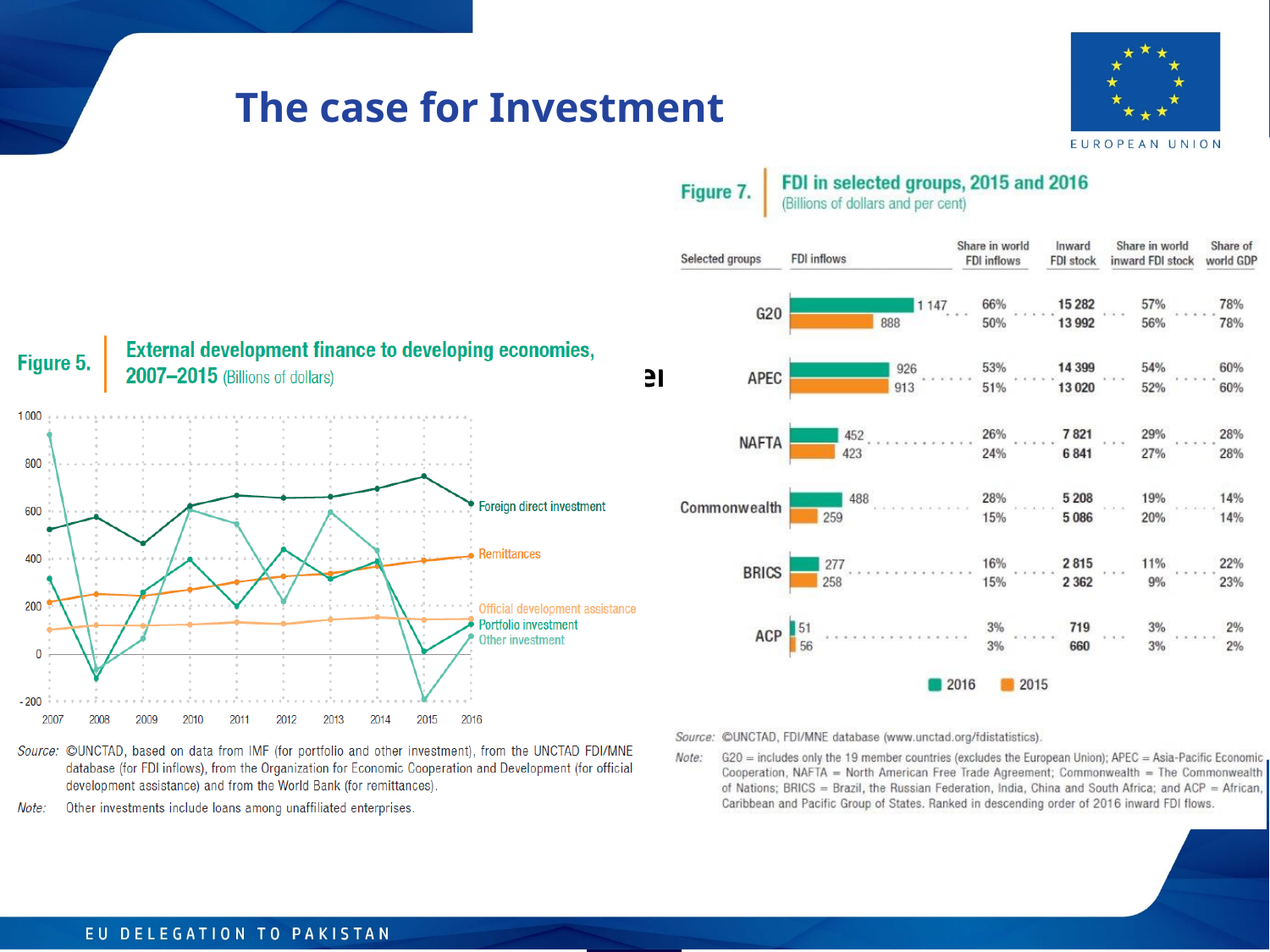
In Figure 7, how many selected groups are shown? 6 In Figure 7, what was the FDI inflow for Commonwealth in 2015? 259 In Figure 7, how many series does the legend list? 2 In Figure 7, what is the difference between G20's FDI inflows in 2016 and 2015? 259 In Figure 7, what was the FDI inflow for G20 in 2016? 1 147 What kind of chart is Figure 5? Line chart In Figure 7, which selected group had the lowest FDI inflows in 2015? ACP In Figure 7, which was larger for ACP: FDI inflows in 2016 or in 2015? 2015 In Figure 5, how many series does the chart show? 5 In Figure 7, which selected group had the highest FDI inflows in 2016? G20 What kind of chart is Figure 7? Bar chart